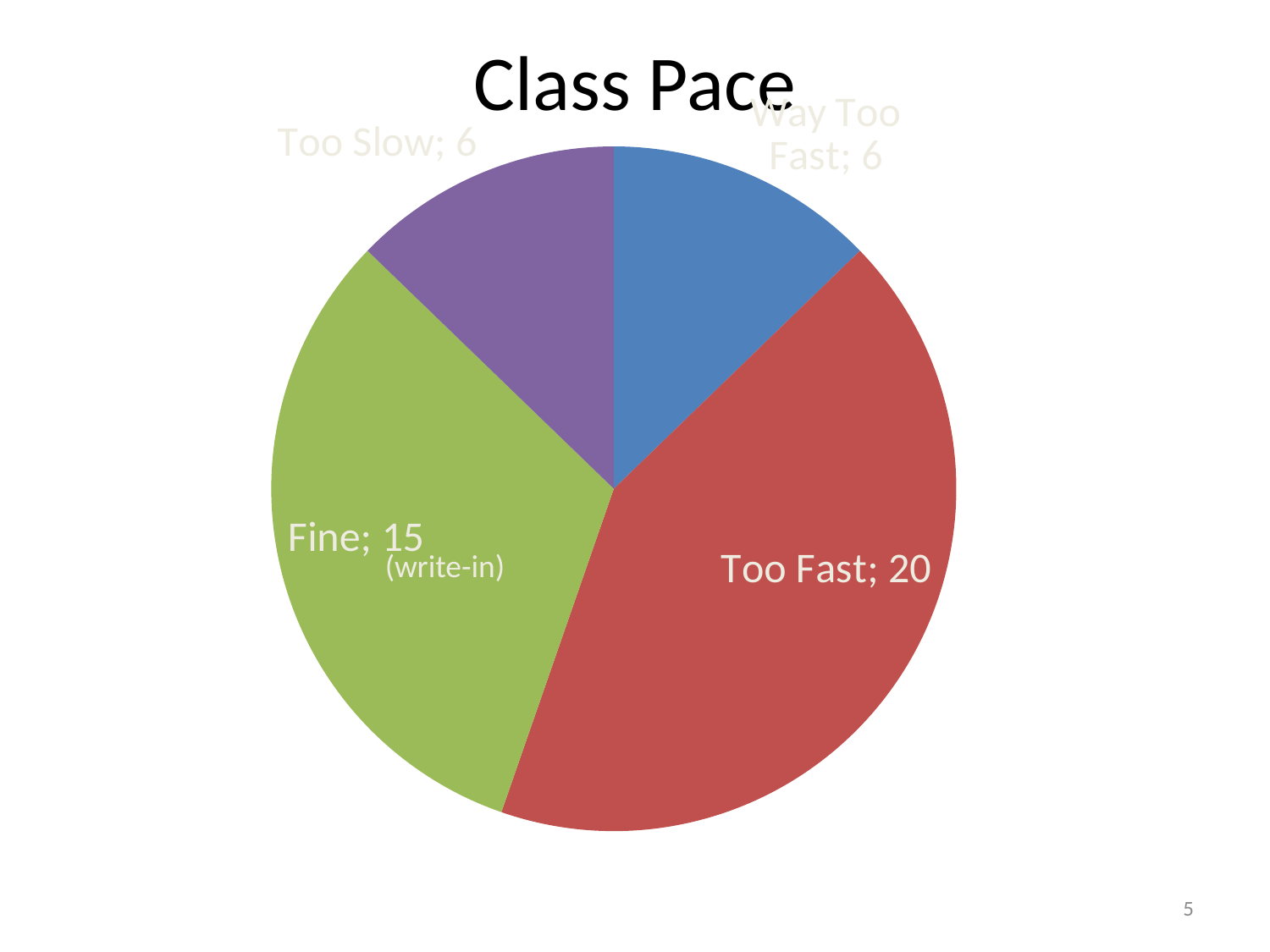
Which category has the largest slice? Too Fast What is the value for Too Fast? 20 What is the value for Too Slow? 6 How many slices does the pie chart have? 4 What is the title of the chart? Class Pace What is the total of all the slice values in the pie chart? 47 What is the value for Fine? 15 What is the difference between the values for Too Fast and Fine? 5 What type of chart is shown on the slide? pie chart Which is larger, the value for Fine or the value for Too Slow? Fine What colour is the Too Fast slice? red What is the value for Way Too Fast? 6